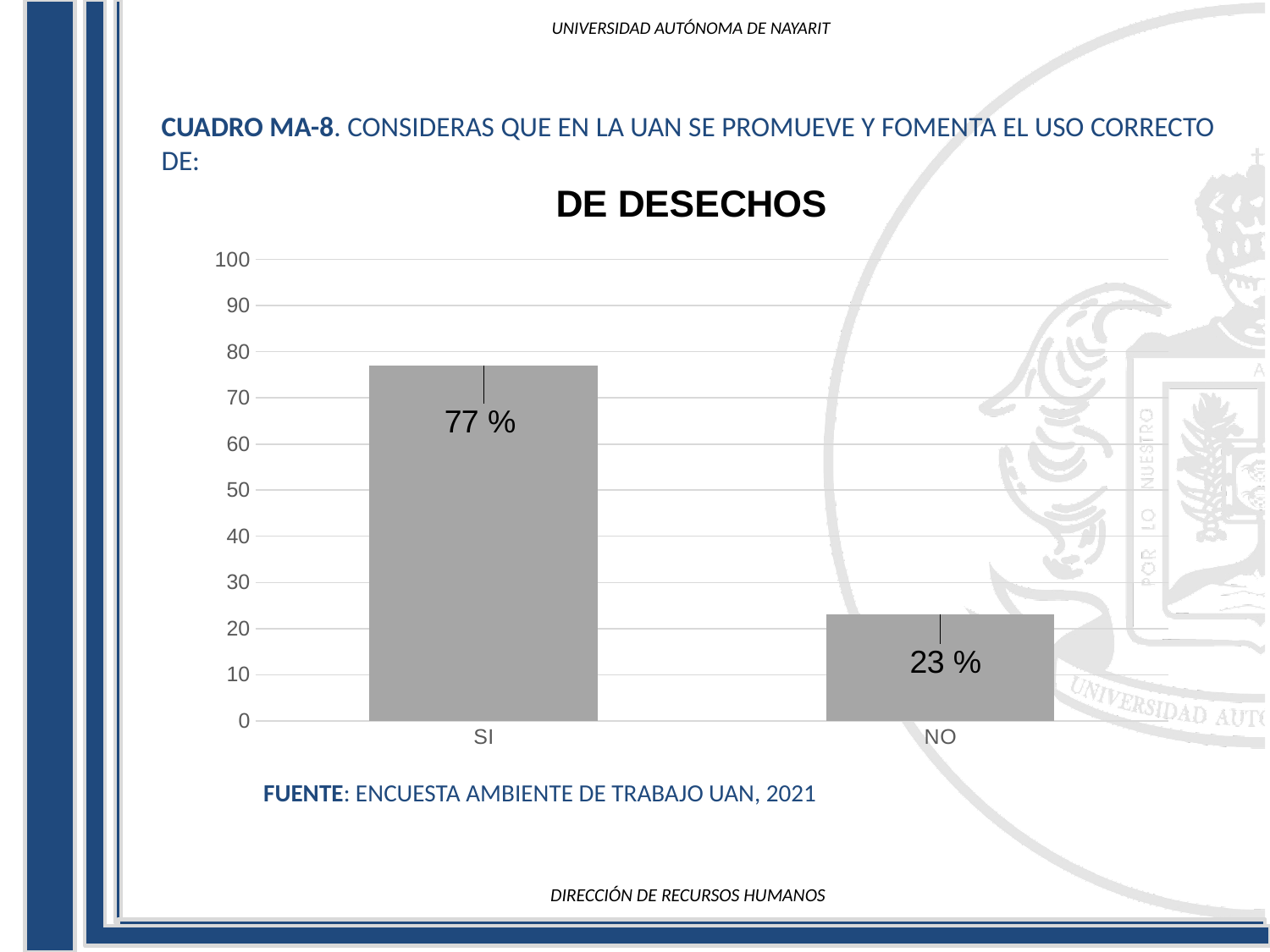
Is the value for SI greater or less than 70? greater What is the difference between the values for SI and NO? 54 % What is the title of the chart? DE DESECHOS What is the highest value shown on the y axis? 100 Is the value for NO greater or less than 30? less How many categories are shown on the x axis? 2 What is the value for NO? 23 % Which category has the lowest value? NO Which category has the highest value? SI What kind of chart is shown? bar chart What is the value for SI? 77 % Which is larger, the value for SI or the value for NO? SI